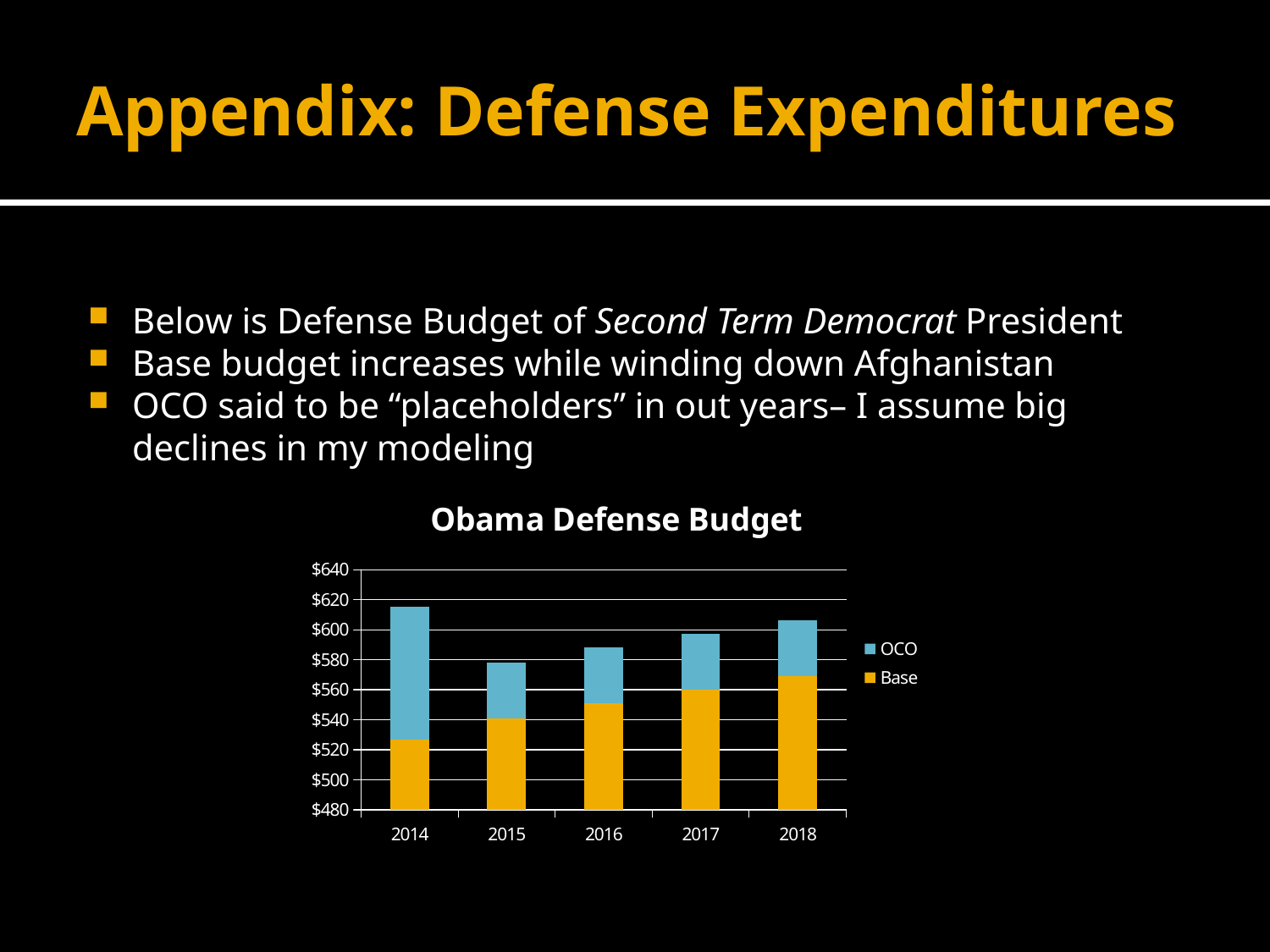
Which year has the largest Base segment? 2018 Which year has the smallest Base segment? 2014 Which year has the highest total defense budget bar? 2014 What kind of chart is shown on the slide? Stacked bar chart What is the title of the chart? Obama Defense Budget Is the Base value for 2014 greater or less than $540? less Does the Base segment rise or fall from 2014 to 2018? Rises How many series does the chart's legend list? 2 Is the total bar for 2014 greater or less than $600? greater Which year has the lowest total defense budget bar? 2015 How many years are shown on the x axis of the chart? 5 Which two series are listed in the chart's legend? OCO and Base